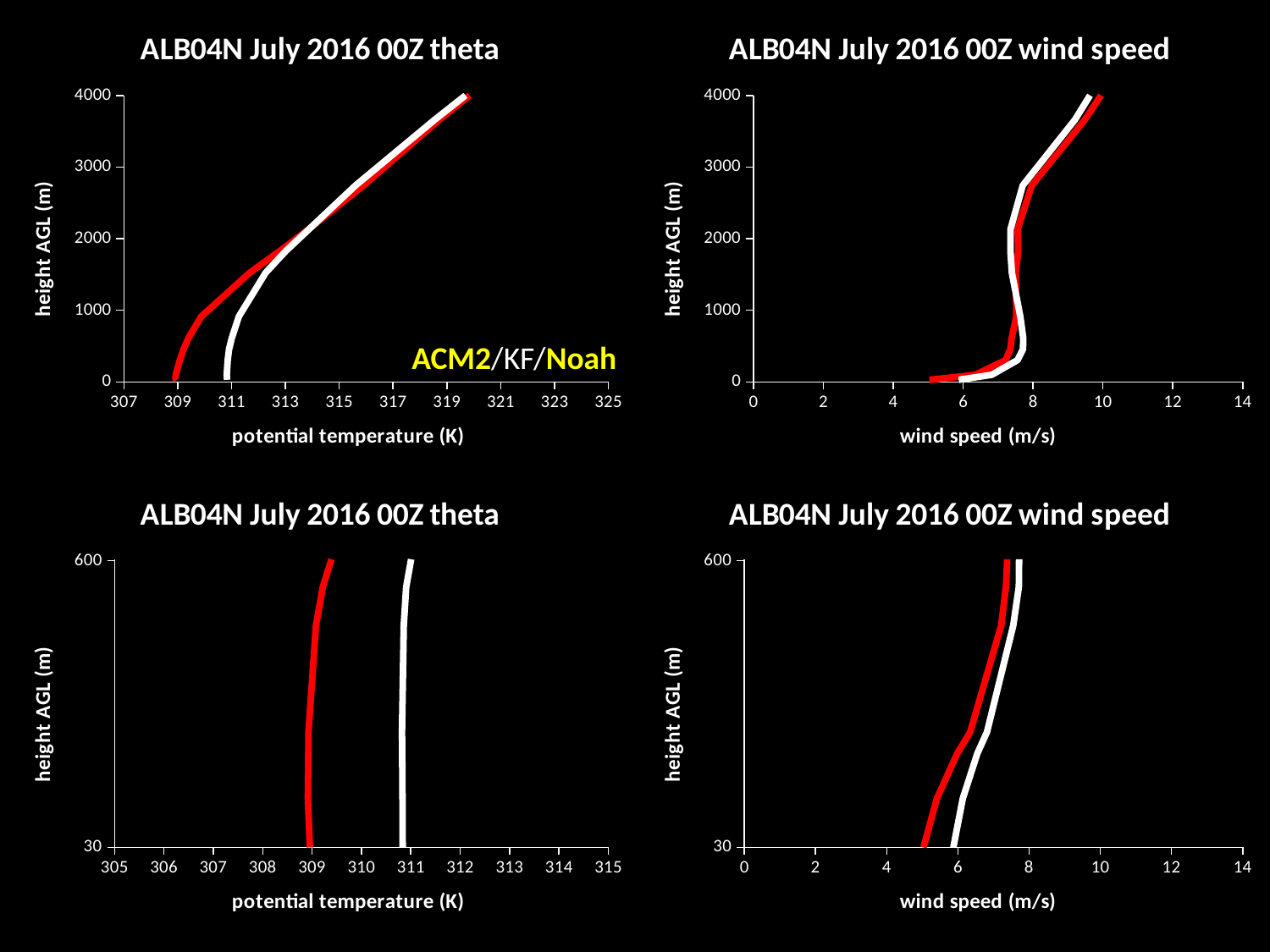
In the top-left theta chart, does potential temperature rise or fall as height AGL increases? rise What is the y-axis label of the bottom-left chart? height AGL (m) In the top-right wind speed chart, is the wind speed of the red line at 0 m height greater or less than 6 m/s? less In the top-left theta chart, is the potential temperature of the red line at 0 m height greater or less than 311 K? less In the bottom-left theta chart, is the potential temperature of the white line at 30 m height greater or less than 310 K? greater In the bottom-left theta chart, which line shows the higher potential temperature at 30 m height, the red line or the white line? white line In the bottom-right wind speed chart, does wind speed rise or fall as height AGL increases from 30 m to 600 m? rise What is the x-axis label of the top-right chart? wind speed (m/s) How many charts are shown on the slide? 4 What kind of chart is the top-left chart titled 'ALB04N July 2016 00Z theta'? line chart